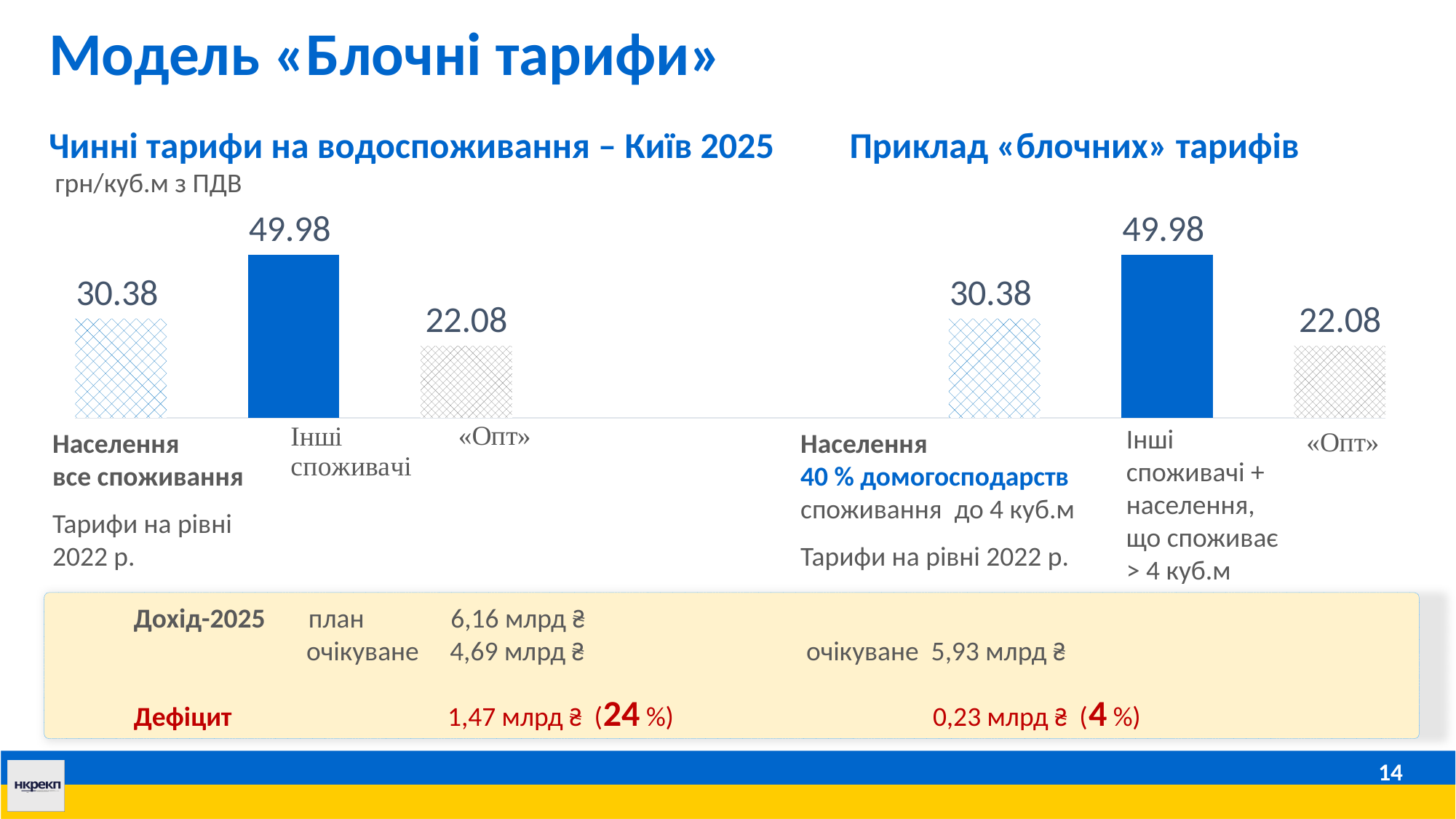
How many bars are plotted in the right chart (Приклад «блочних» тарифів)? 3 What kind of chart is the left chart (Чинні тарифи на водоспоживання – Київ 2025)? Bar chart In the left chart (Чинні тарифи на водоспоживання – Київ 2025), what is the difference between the values for Інші споживачі and Населення? 19.60 In the left chart (Чинні тарифи на водоспоживання – Київ 2025), what is the value for «Опт»? 22.08 In the left chart (Чинні тарифи на водоспоживання – Київ 2025), what is the value for Населення? 30.38 In the left chart (Чинні тарифи на водоспоживання – Київ 2025), what is the value for Інші споживачі? 49.98 In the left chart (Чинні тарифи на водоспоживання – Київ 2025), which category has the highest value? Інші споживачі What unit is stated above the left chart (Чинні тарифи на водоспоживання – Київ 2025)? грн/куб.м з ПДВ In the right chart (Приклад «блочних» тарифів), what is the value for «Опт»? 22.08 In the right chart (Приклад «блочних» тарифів), which category has the lowest value? «Опт» In the right chart (Приклад «блочних» тарифів), what is the difference between the values for Населення and «Опт»? 8.30 In the left chart (Чинні тарифи на водоспоживання – Київ 2025), which is larger: the value for Населення or the value for «Опт»? Населення